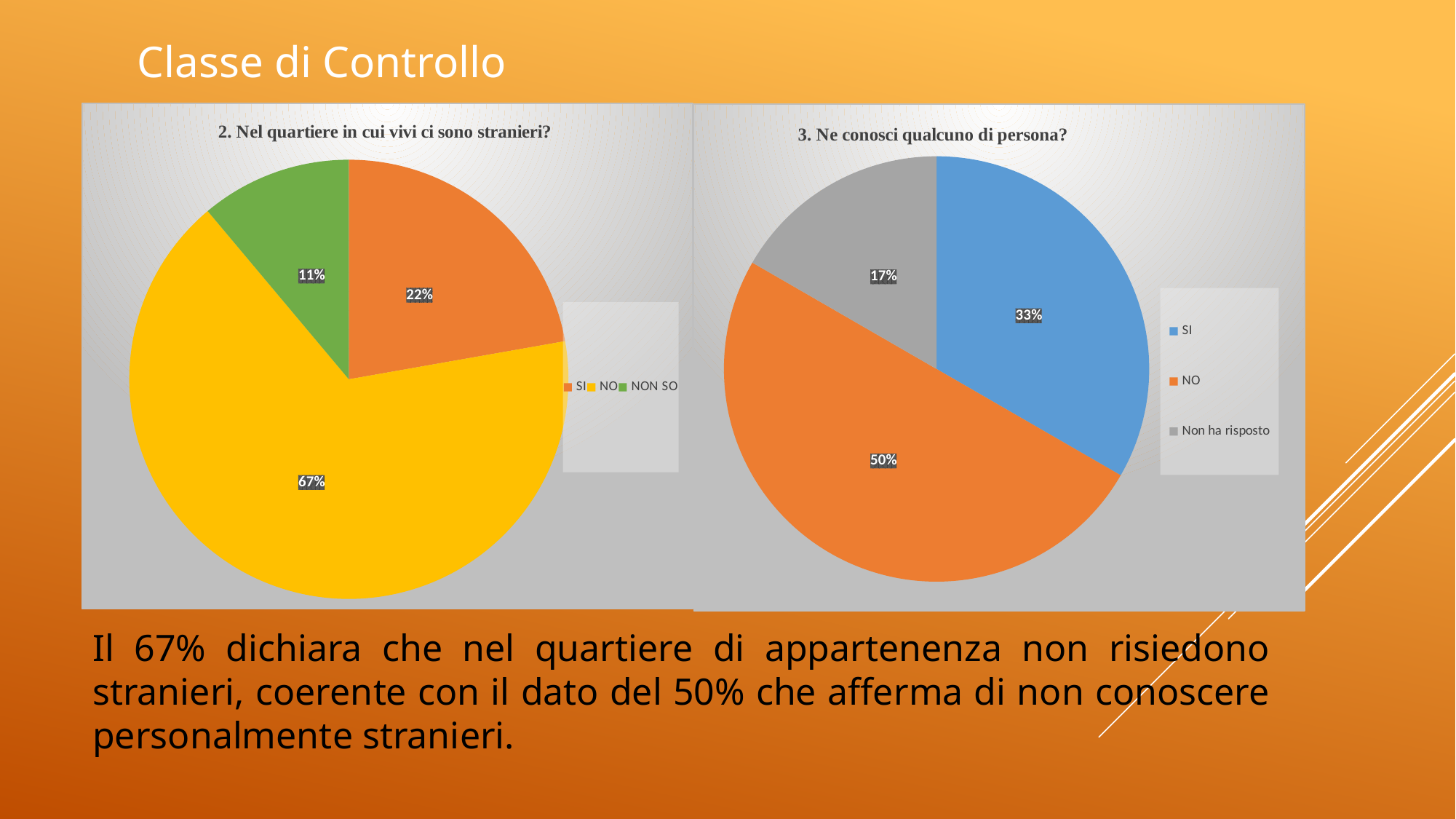
In the chart titled "3. Ne conosci qualcuno di persona?", what is the value for Non ha risposto? 17% In the chart titled "2. Nel quartiere in cui vivi ci sono stranieri?", which category has the largest slice? NO In the chart titled "3. Ne conosci qualcuno di persona?", what is the value for NO? 50% In the chart titled "2. Nel quartiere in cui vivi ci sono stranieri?", what share of the pie is NO? 67% In the chart titled "2. Nel quartiere in cui vivi ci sono stranieri?", what is the value for SI? 22% In the chart titled "3. Ne conosci qualcuno di persona?", what is the value for SI? 33% In the chart titled "3. Ne conosci qualcuno di persona?", which is larger, SI or Non ha risposto? SI In the chart titled "2. Nel quartiere in cui vivi ci sono stranieri?", what is the value for NON SO? 11% In the chart titled "2. Nel quartiere in cui vivi ci sono stranieri?", which category has the smallest slice? NON SO What kind of chart is the chart titled "2. Nel quartiere in cui vivi ci sono stranieri?"? Pie chart In the chart titled "3. Ne conosci qualcuno di persona?", how many categories does the legend list? 3 In the chart titled "2. Nel quartiere in cui vivi ci sono stranieri?", what is the difference between NO and SI? 45%